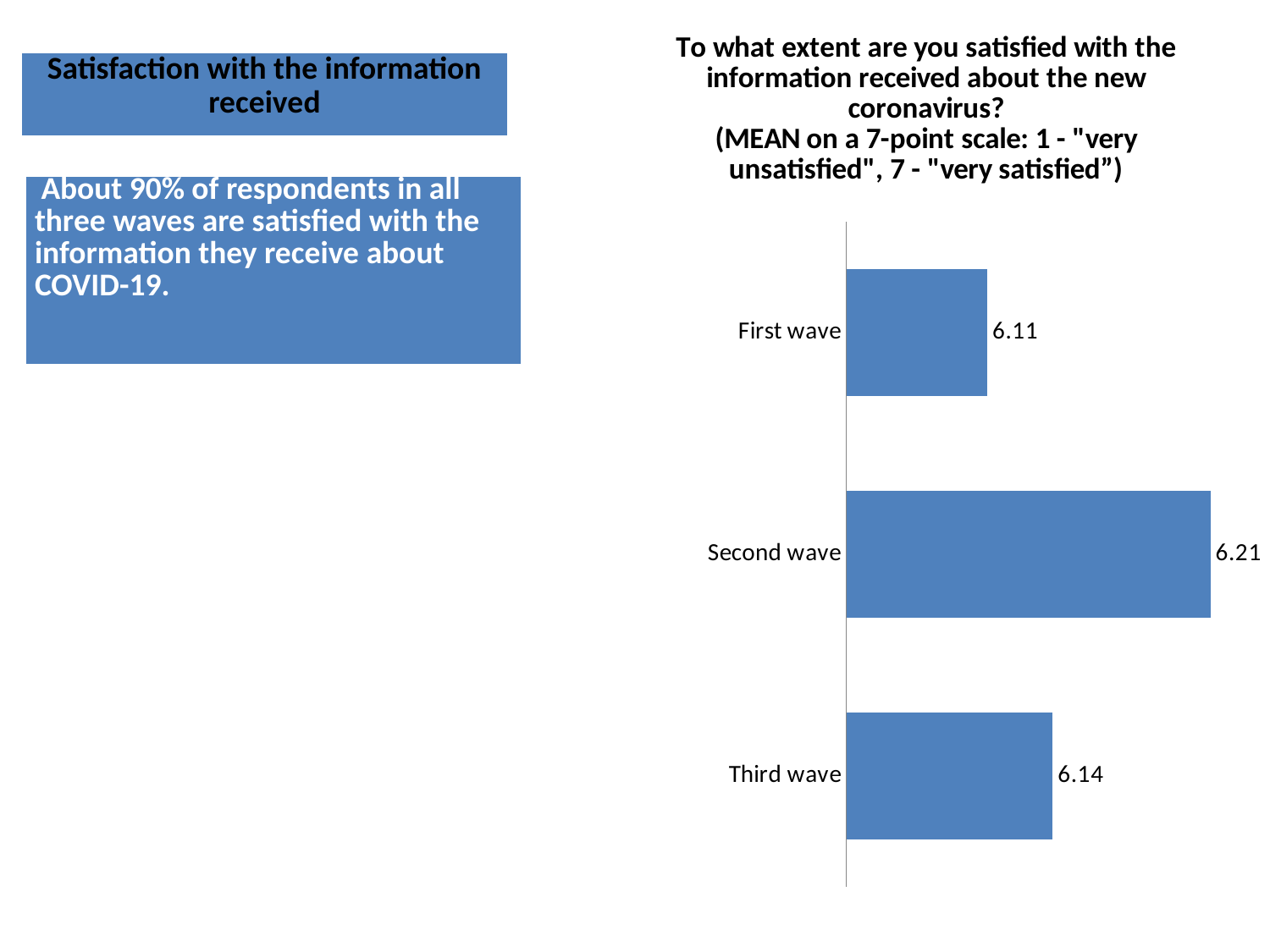
Which is larger, the value for Second wave or Third wave? Second wave What is the value for Third wave? 6.14 What scale is the mean measured on, according to the chart title? 7-point scale What is the value for Second wave? 6.21 What is the difference between the Second wave and First wave values? 0.10 How many categories are shown in the chart? 3 What is the difference between the Third wave and First wave values? 0.03 What kind of chart is shown on the slide? Bar chart Which wave has the highest value? Second wave Which wave has the lowest value? First wave What is the value for First wave? 6.11 What colour are the bars in the chart? Blue